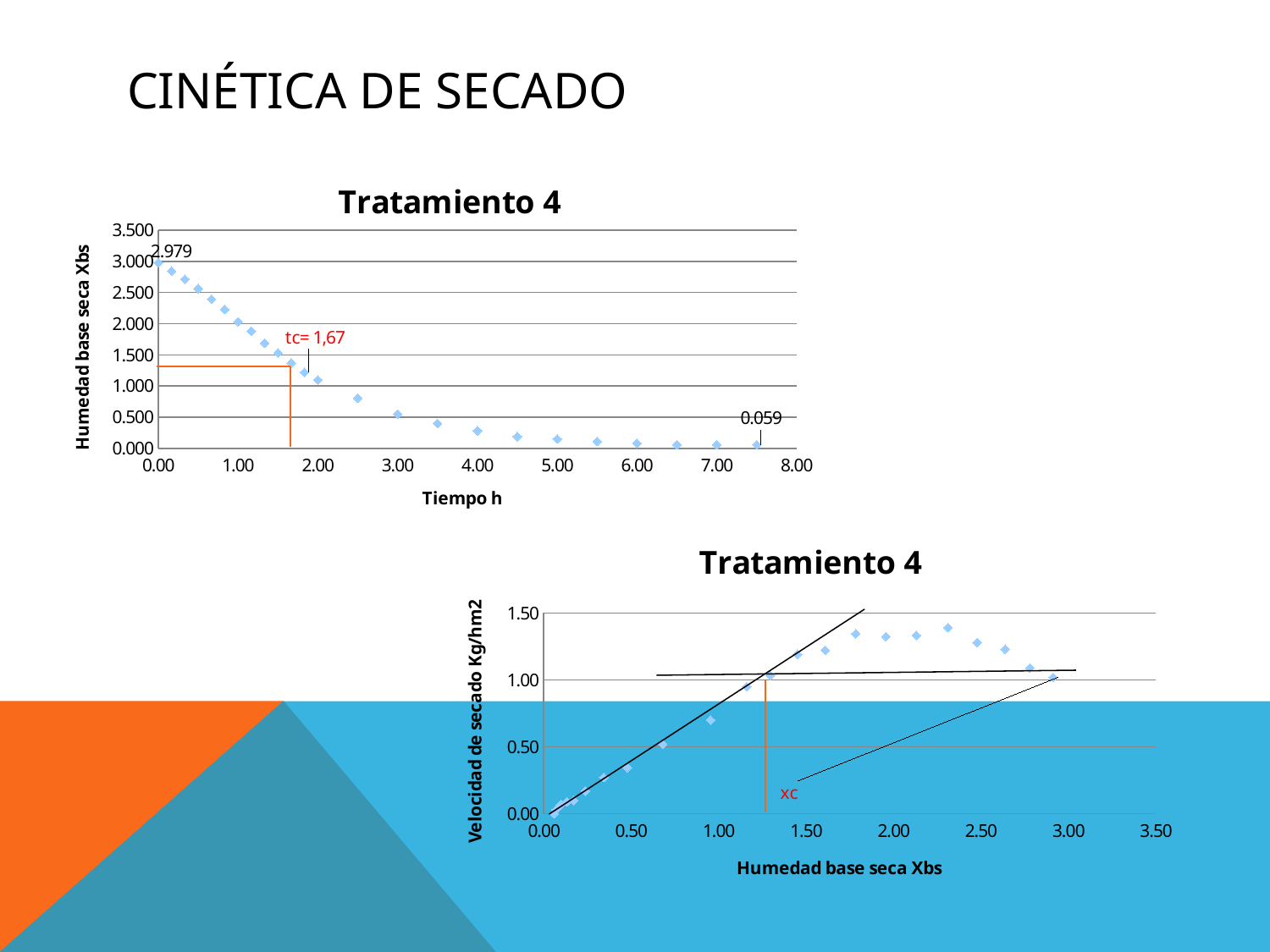
On the bottom chart, is the Velocidad de secado at Humedad base seca Xbs 2.00 greater or less than 1.00? greater What kind of chart is the top chart? scatter chart On the top chart, is the value at Tiempo 4.00 h greater or less than 1.000? less On the top chart, what is the Humedad base seca Xbs value at Tiempo 7.50 h? 0.059 What is the y-axis title of the bottom chart? Velocidad de secado Kg/hm2 On the top chart, what value of tc is annotated in red? tc= 1,67 On the top chart, what is the difference between the labelled values at 0.00 h and 7.50 h? 2.920 On the top chart, which is larger: the value at 0.00 h or the value at 7.50 h? 0.00 h On the top chart, is the value at Tiempo 1.00 h greater or less than 1.500? greater On the top chart, do the values rise or fall as Tiempo increases? fall On the top chart, what is the Humedad base seca Xbs value at Tiempo 0.00 h? 2.979 On the top chart, at which time is the Humedad base seca Xbs highest? 0.00